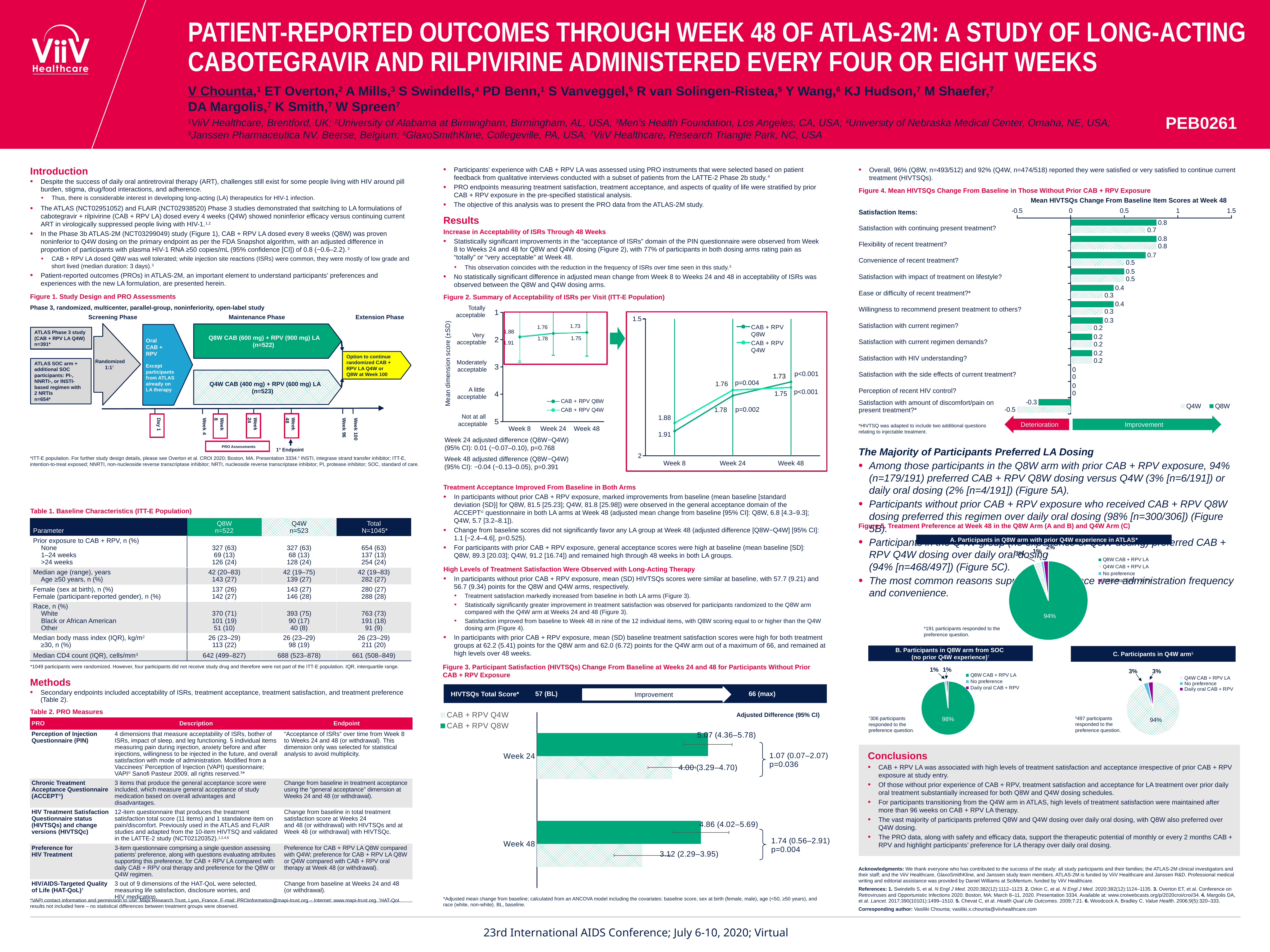
In Figure 4 (Mean HIVTSQs Change From Baseline Item Scores at Week 48), which satisfaction item has the lowest scores? Satisfaction with amount of discomfort/pain on present treatment?* In Figure 4 (Mean HIVTSQs Change From Baseline Item Scores at Week 48), how many satisfaction items are listed? 12 In Figure 3 (Participant Satisfaction (HIVTSQs) Change From Baseline), which is larger at Week 48: CAB + RPV Q8W or CAB + RPV Q4W? CAB + RPV Q8W In Figure 5A (Participants in Q8W arm with prior Q4W experience in ATLAS), what share of participants preferred Q8W CAB + RPV LA? 94% What kind of chart is Figure 3 (Participant Satisfaction (HIVTSQs) Change From Baseline at Weeks 24 and 48)? bar chart In Figure 2 (Summary of Acceptability of ISRs per Visit), how many series does the legend list? 2 In Figure 4 (Mean HIVTSQs Change From Baseline Item Scores at Week 48), what is the value for Q4W for 'Satisfaction with impact of treatment on lifestyle?' 0.5 In Figure 2 (Summary of Acceptability of ISRs per Visit), what is the mean dimension score for CAB + RPV Q8W at Week 8? 1.91 In Figure 3 (Participant Satisfaction (HIVTSQs) Change From Baseline), what is the value for CAB + RPV Q8W at Week 24? 5.07 (4.36–5.78) In Figure 2 (Summary of Acceptability of ISRs per Visit), what is the mean dimension score for CAB + RPV Q4W at Week 48? 1.75 In Figure 2 (Summary of Acceptability of ISRs per Visit), do the labelled values for CAB + RPV Q8W increase or decrease from Week 8 to Week 48? decrease In Figure 3 (Participant Satisfaction (HIVTSQs) Change From Baseline), what is the adjusted difference (95% CI) shown for Week 48? 1.74 (0.56–2.91)